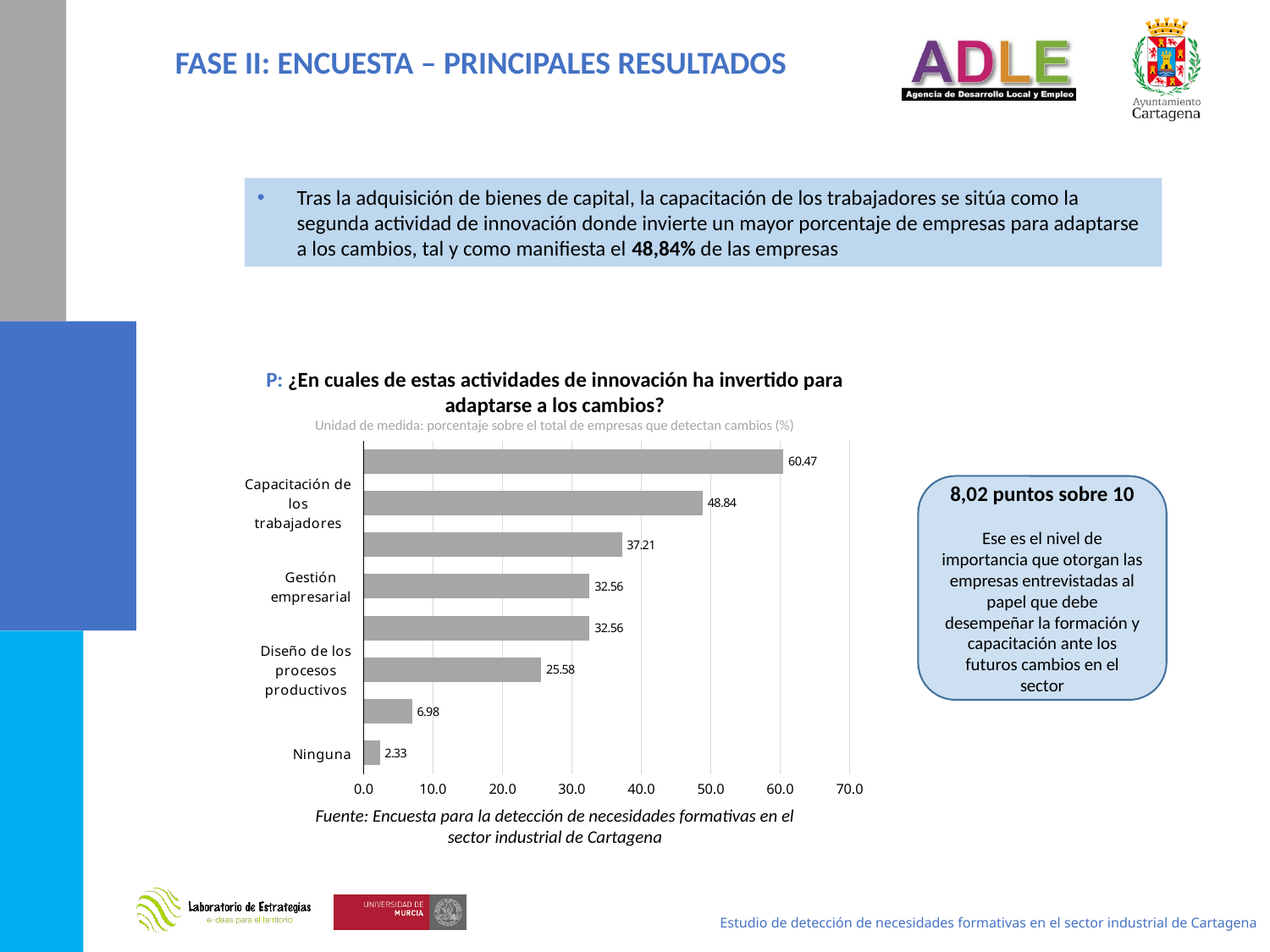
Which labelled category has the lowest value? Ninguna What is the difference between the values for Gestión empresarial and Diseño de los procesos productivos? 6.98 What is the difference between the values for Capacitación de los trabajadores and Gestión empresarial? 16.28 What is the value for Ninguna? 2.33 What is the value for Diseño de los procesos productivos? 25.58 What is the value for Capacitación de los trabajadores? 48.84 Is the value for Gestión empresarial greater or less than 40.0? less What is the highest value shown in the chart? 60.47 Which is larger, the value for Capacitación de los trabajadores or the value for Diseño de los procesos productivos? Capacitación de los trabajadores What is the value for Gestión empresarial? 32.56 How many bars are plotted in the chart? 8 What kind of chart is shown on the slide? Bar chart